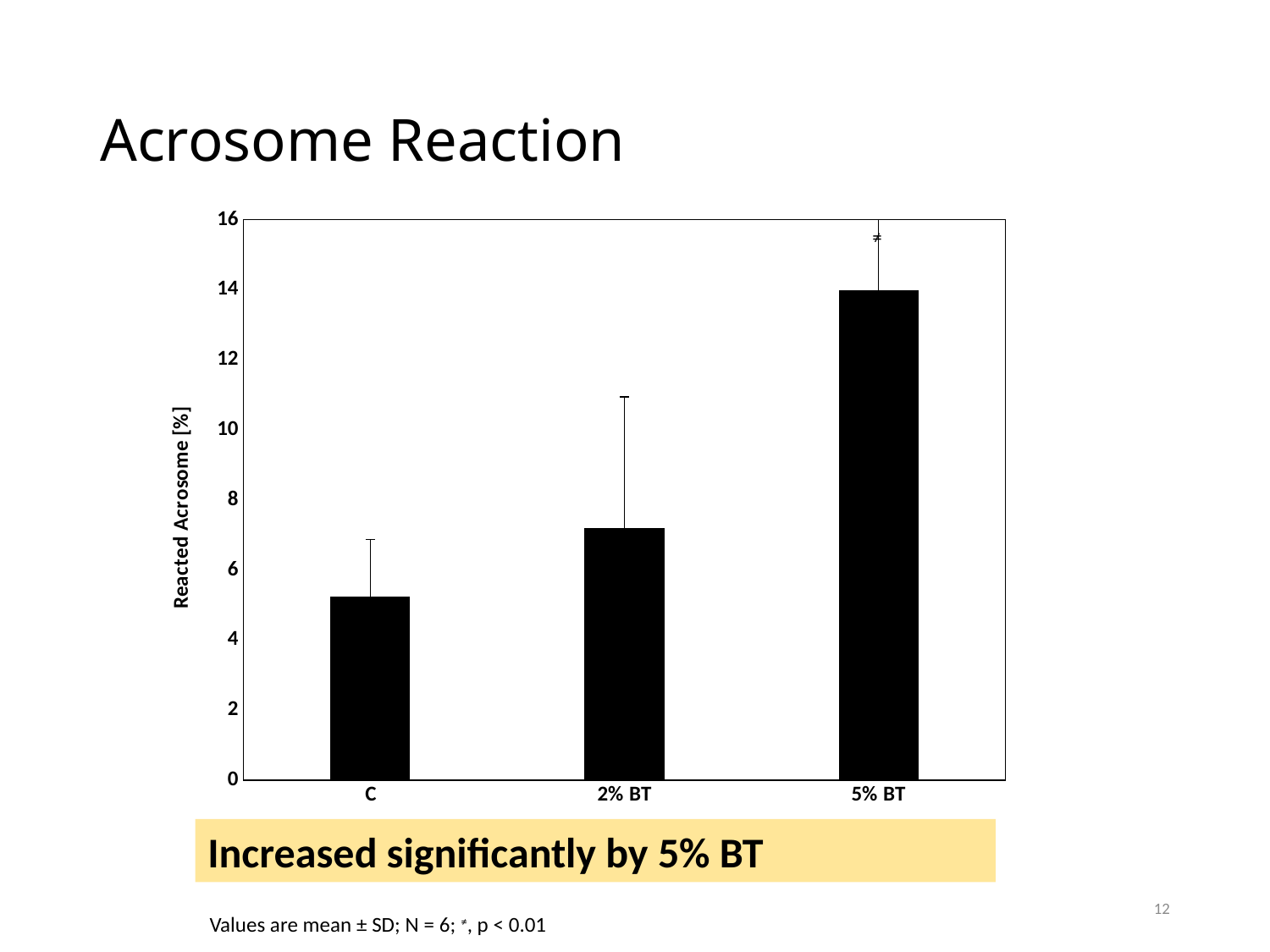
What is the label of the y axis? Reacted Acrosome [%] Do the bar values rise or fall from C to 5% BT along the x axis? rise Which category has the lowest reacted acrosome value? C How many categories are plotted on the x axis? 3 Is the value for 2% BT greater or less than 8? less Which has a larger value, C or 2% BT? 2% BT Is the value for C greater or less than 6? less Is the value for 5% BT greater or less than 12? greater Which bar is marked with an asterisk indicating significance? 5% BT Which category has the highest reacted acrosome value? 5% BT What kind of chart is shown on the slide? bar chart